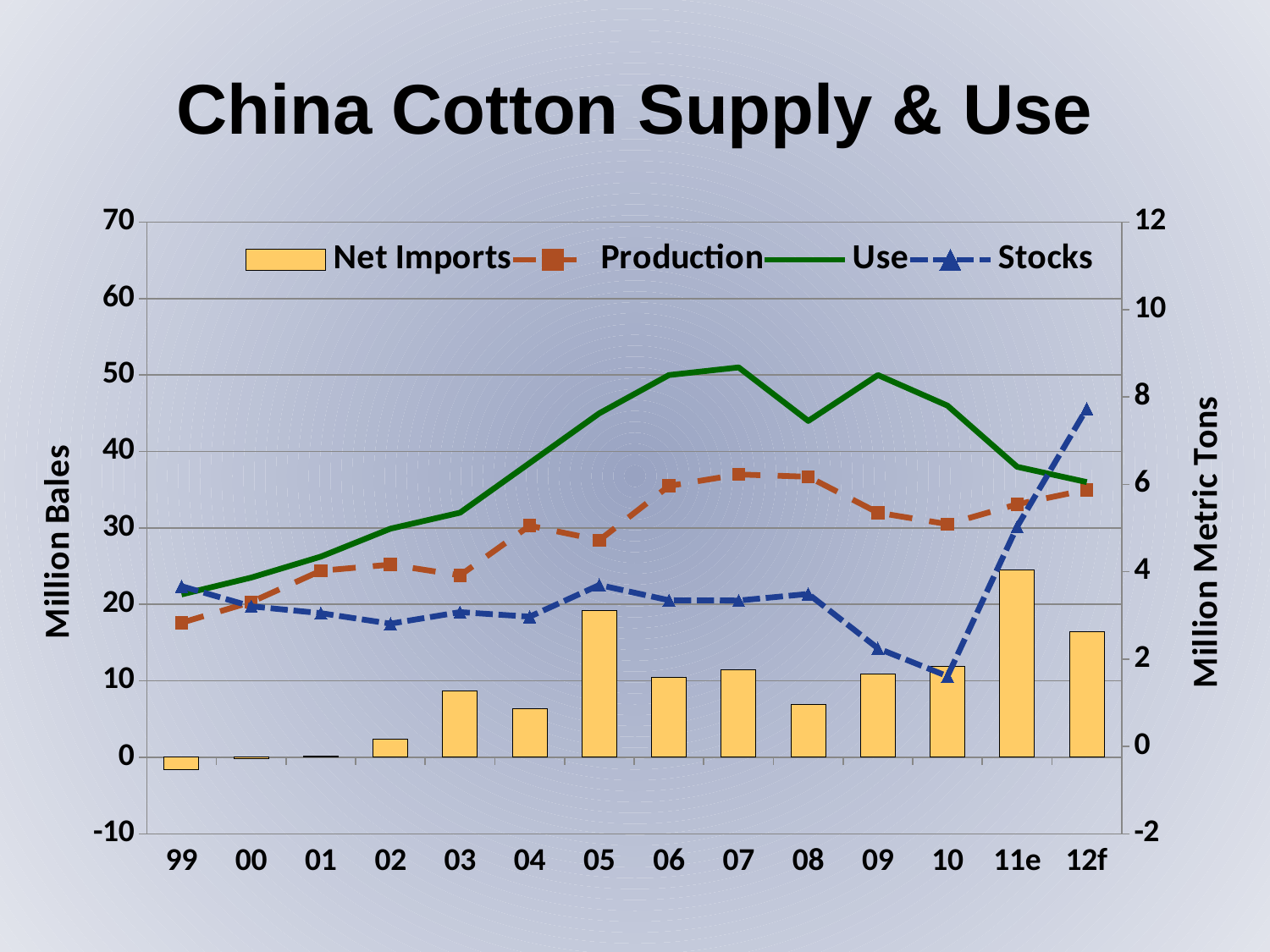
Which year has the highest Net Imports bar? 11e How many years are shown on the x axis? 14 Does the Use line rise or fall from 99 to 07? Rise Which year has the lowest Net Imports bar? 99 Which year has the highest Stocks value? 12f What kind of chart is this? Combination bar and line chart What is the title of the chart? China Cotton Supply & Use Is the Net Imports value for 11e greater or less than 20 million bales? greater In 07, which is larger, Use or Production? Use Which year has the lowest Stocks value? 10 How many series does the legend list? 4 Is the Use value for 08 greater or less than 50 million bales? less